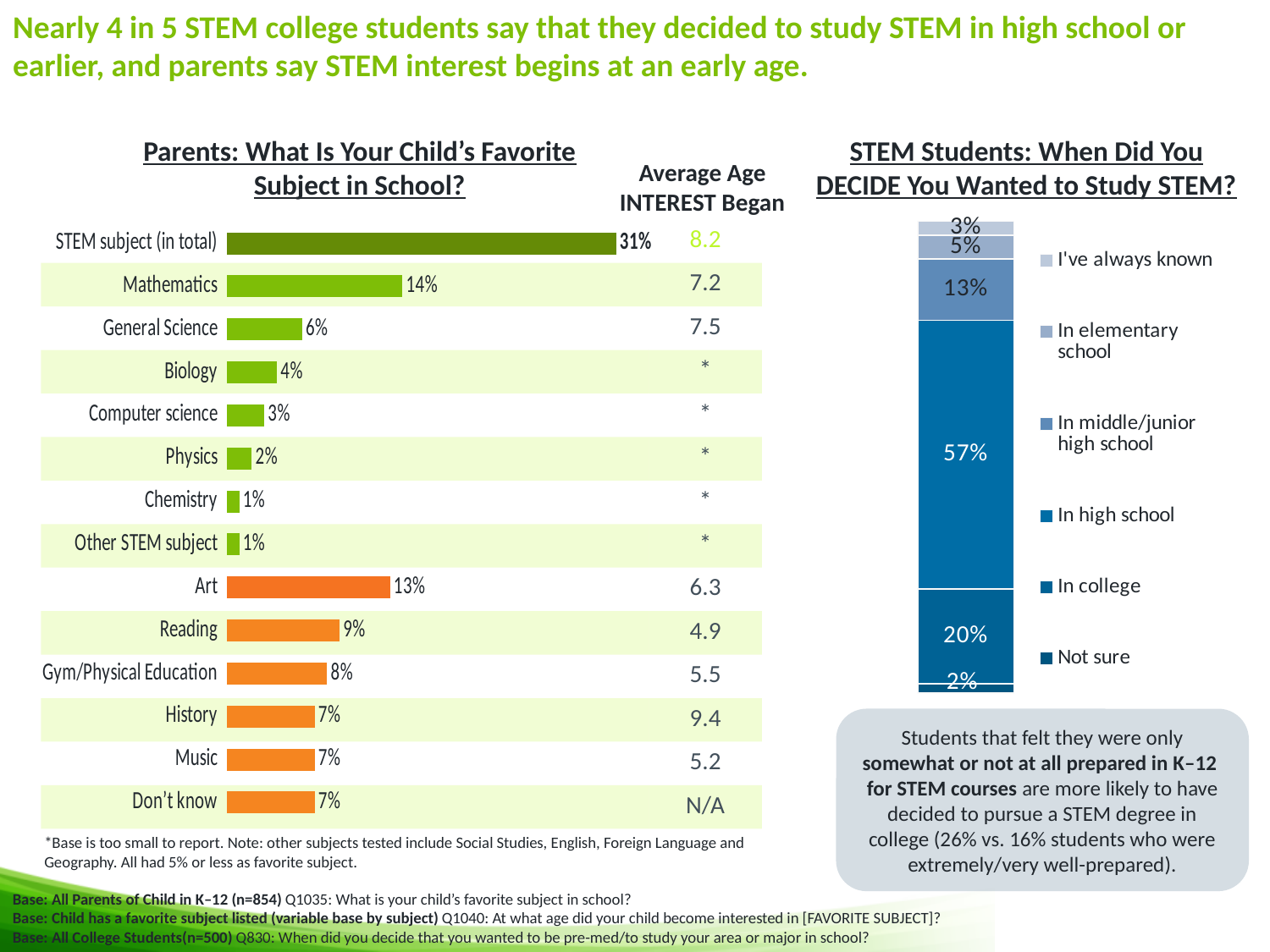
In the chart 'Parents: What Is Your Child's Favorite Subject in School?', what percentage of parents said Mathematics? 14% In the chart 'Parents: What Is Your Child's Favorite Subject in School?', which is larger, the value for Reading or the value for Gym/Physical Education? Reading How many categories are listed in the chart 'Parents: What Is Your Child's Favorite Subject in School?' 14 In the 'Average Age INTEREST Began' column, what is the value for History? 9.4 What type of chart is 'Parents: What Is Your Child's Favorite Subject in School?' Bar chart In the chart 'STEM Students: When Did You DECIDE You Wanted to Study STEM?', what is the difference between the 'In high school' and 'In middle/junior high school' values? 44% In the chart 'Parents: What Is Your Child's Favorite Subject in School?', which category has the highest value? STEM subject (in total) In the chart 'STEM Students: When Did You DECIDE You Wanted to Study STEM?', what percentage of students said 'In college'? 20% How many entries does the legend list in the chart 'STEM Students: When Did You DECIDE You Wanted to Study STEM?' 6 In the chart 'Parents: What Is Your Child's Favorite Subject in School?', what percentage is shown for Art? 13% In the chart 'STEM Students: When Did You DECIDE You Wanted to Study STEM?', what percentage of students said 'In high school'? 57% In the chart 'Parents: What Is Your Child's Favorite Subject in School?', what is the difference between the values for Mathematics and General Science? 8%